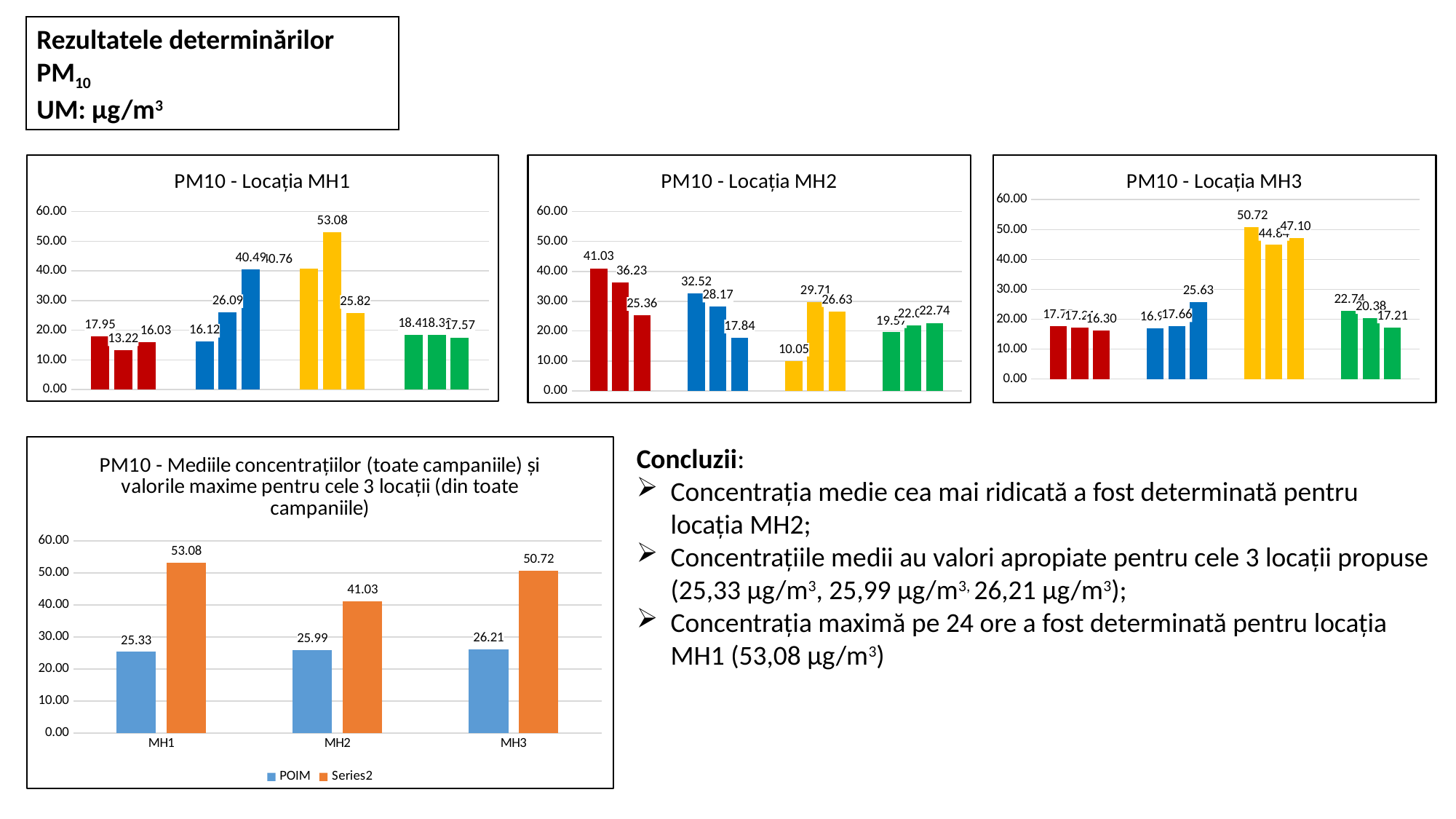
In the bottom chart 'PM10 - Mediile concentrațiilor...', which location has the highest Series2 value? MH1 In the chart 'PM10 - Locația MH2', what is the lowest labelled value? 10.05 In the bottom chart 'PM10 - Mediile concentrațiilor...', what is the POIM value for MH2? 25.99 In the bottom chart 'PM10 - Mediile concentrațiilor...', which location has the lowest POIM value? MH1 In the bottom chart 'PM10 - Mediile concentrațiilor...', what is the difference between the Series2 and POIM values for MH1? 27.75 In the chart 'PM10 - Locația MH1', what is the highest labelled value? 53.08 What kind of chart is the bottom chart 'PM10 - Mediile concentrațiilor...'? Bar chart In the bottom chart 'PM10 - Mediile concentrațiilor...', what is the Series2 value for MH3? 50.72 In the chart 'PM10 - Locația MH3', what is the highest labelled value? 50.72 In the bottom chart 'PM10 - Mediile concentrațiilor...', which is larger: the POIM value for MH3 or the Series2 value for MH2? Series2 value for MH2 How many series does the legend of the bottom chart 'PM10 - Mediile concentrațiilor...' list? 2 How many locations are shown on the x axis of the bottom chart 'PM10 - Mediile concentrațiilor...'? 3